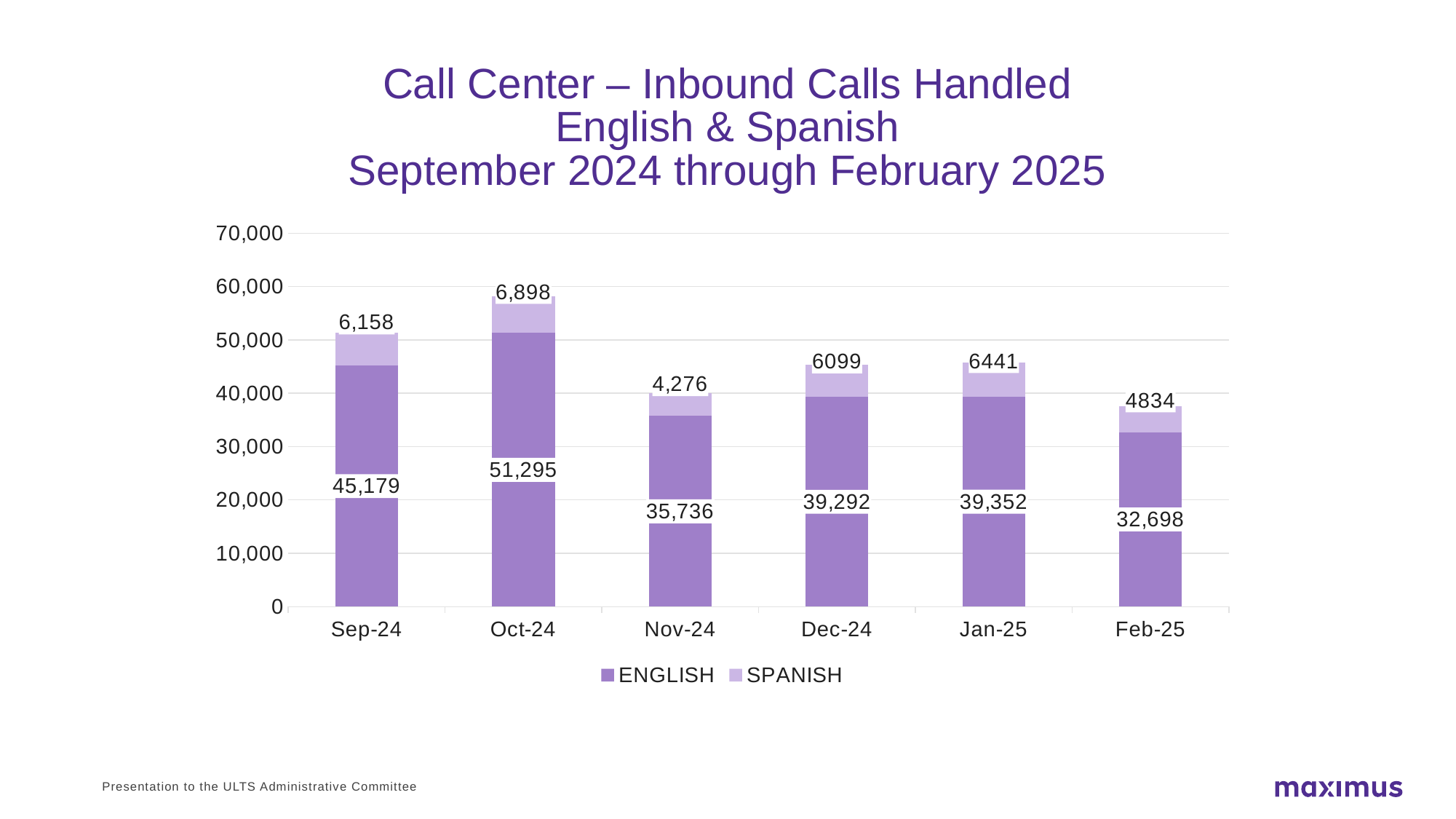
What is the total of the stacked bar for Oct-24? 58,193 Which is larger, the ENGLISH value for Sep-24 or for Nov-24? Sep-24 Which month has the highest ENGLISH value? Oct-24 How many series does the legend list? 2 What is the SPANISH value for Nov-24? 4,276 What is the difference between the ENGLISH values for Oct-24 and Sep-24? 6,116 What is the ENGLISH value for Oct-24? 51,295 What is the ENGLISH value for Feb-25? 32,698 What kind of chart is shown? Stacked bar chart How many months are shown on the x axis? 6 Which month has the lowest SPANISH value? Nov-24 Does the ENGLISH value rise or fall from Oct-24 to Nov-24? Fall